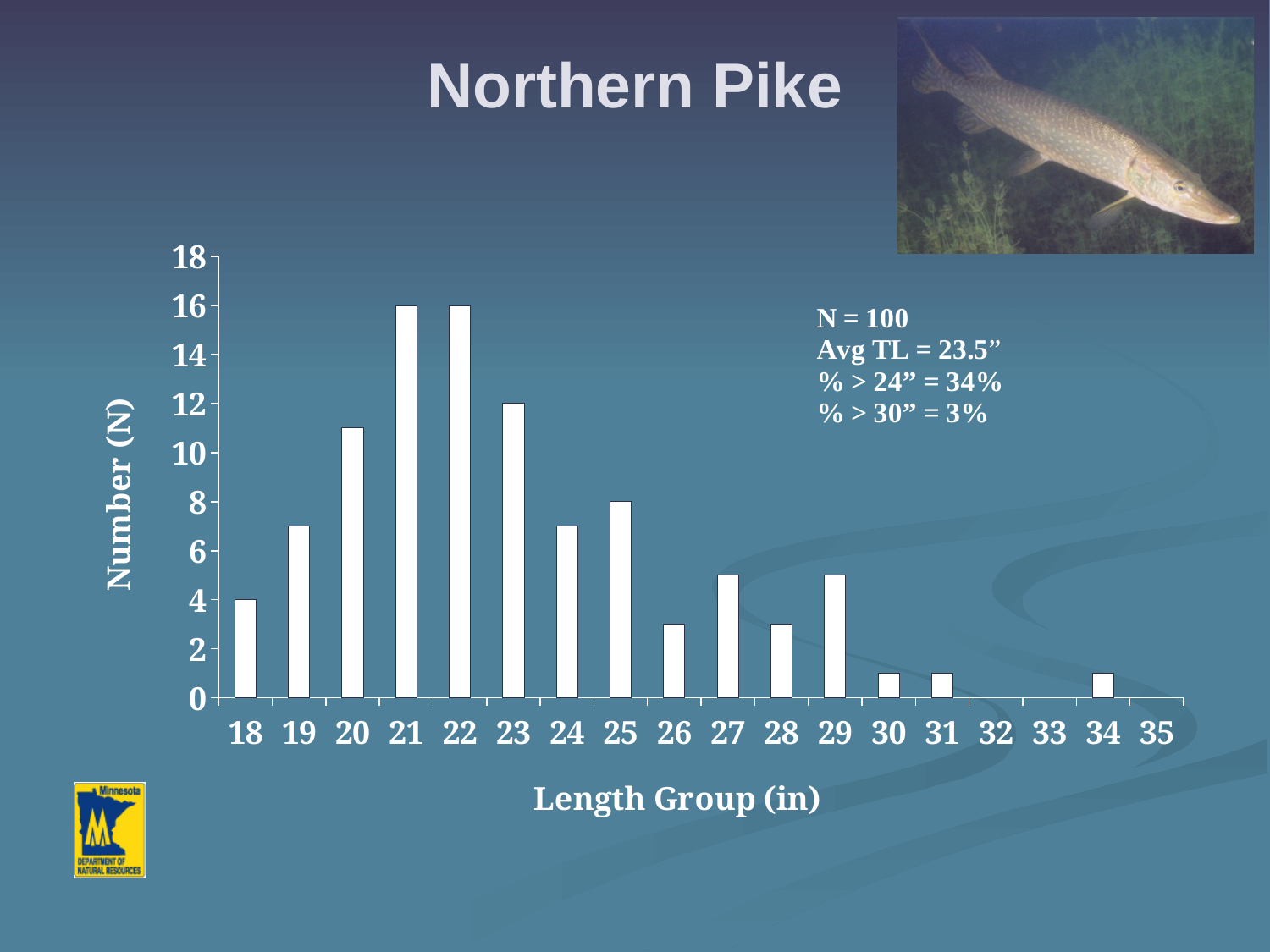
What is the number of fish in the 25-inch length group? 8 What is the number of fish in the 23-inch length group? 12 What is the difference between the number of fish in the 23-inch group and the 18-inch group? 8 Which length group has more fish, 20 inches or 24 inches? 20 What kind of chart is shown on the slide? bar chart Is the value for the 27-inch length group greater or less than 6? less Is the value for the 30-inch length group greater or less than 2? less How many length groups are shown on the x axis? 18 Do the values rise or fall from the 22-inch group to the 26-inch group? fall What is the number of fish in the 18-inch length group? 4 Is the value for the 20-inch length group greater or less than 10? greater What is the number of fish in the 21-inch length group? 16